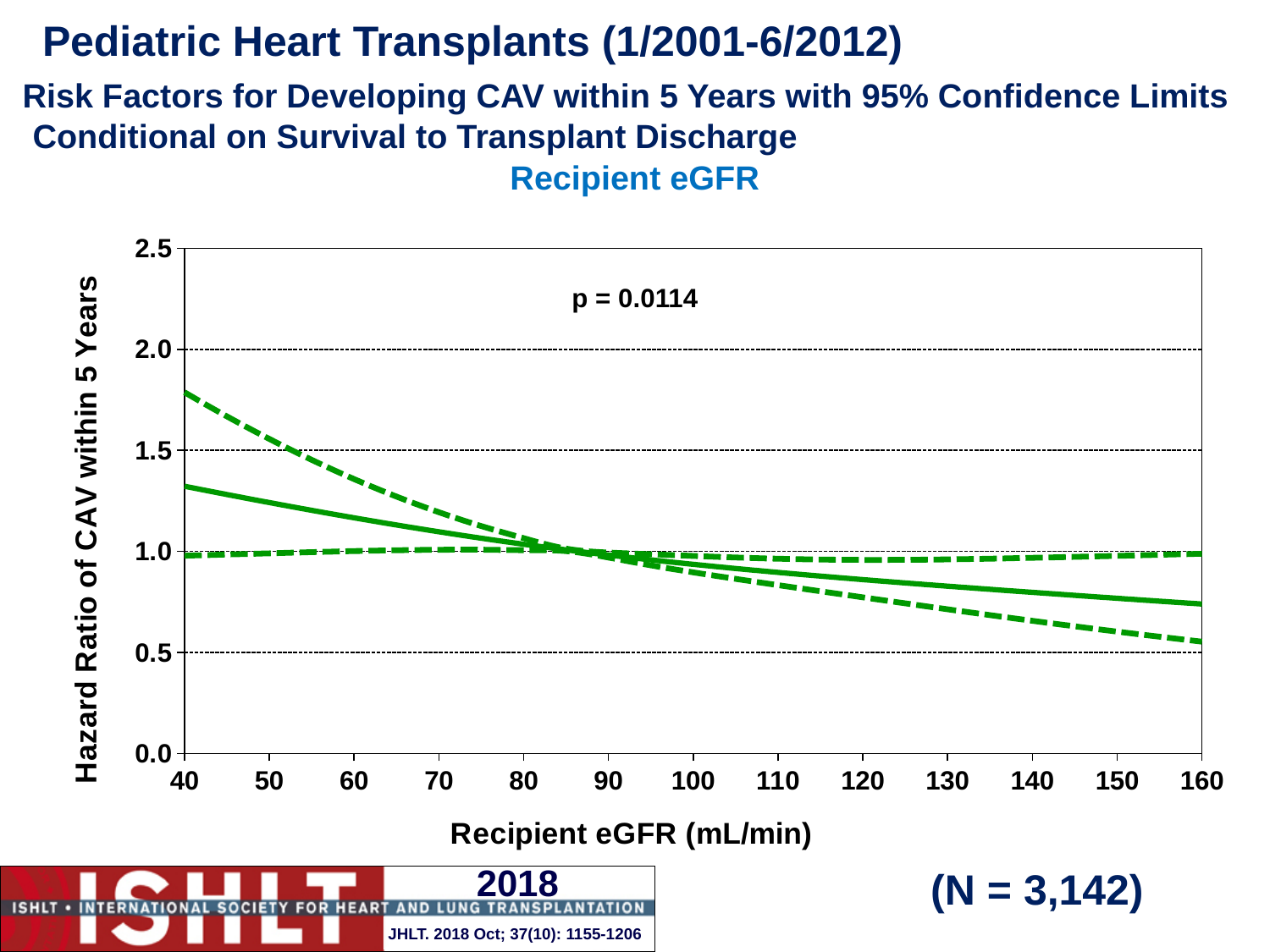
Is the solid hazard ratio line at a Recipient eGFR of 40 mL/min greater or less than 1.5? less Is the solid hazard ratio line at a Recipient eGFR of 40 mL/min greater or less than 1.0? greater How many lines are plotted on the chart? 3 Is the solid hazard ratio line higher at a Recipient eGFR of 40 mL/min or at 160 mL/min? 40 mL/min Is the upper dashed confidence limit at a Recipient eGFR of 40 mL/min greater or less than 2.0? less What kind of chart is shown on the slide? Line chart What p-value is printed on the chart? p = 0.0114 Does the solid hazard ratio line rise or fall as Recipient eGFR increases from 40 to 160 mL/min? Fall What is the highest value shown on the y-axis? 2.5 What is the label of the y-axis? Hazard Ratio of CAV within 5 Years